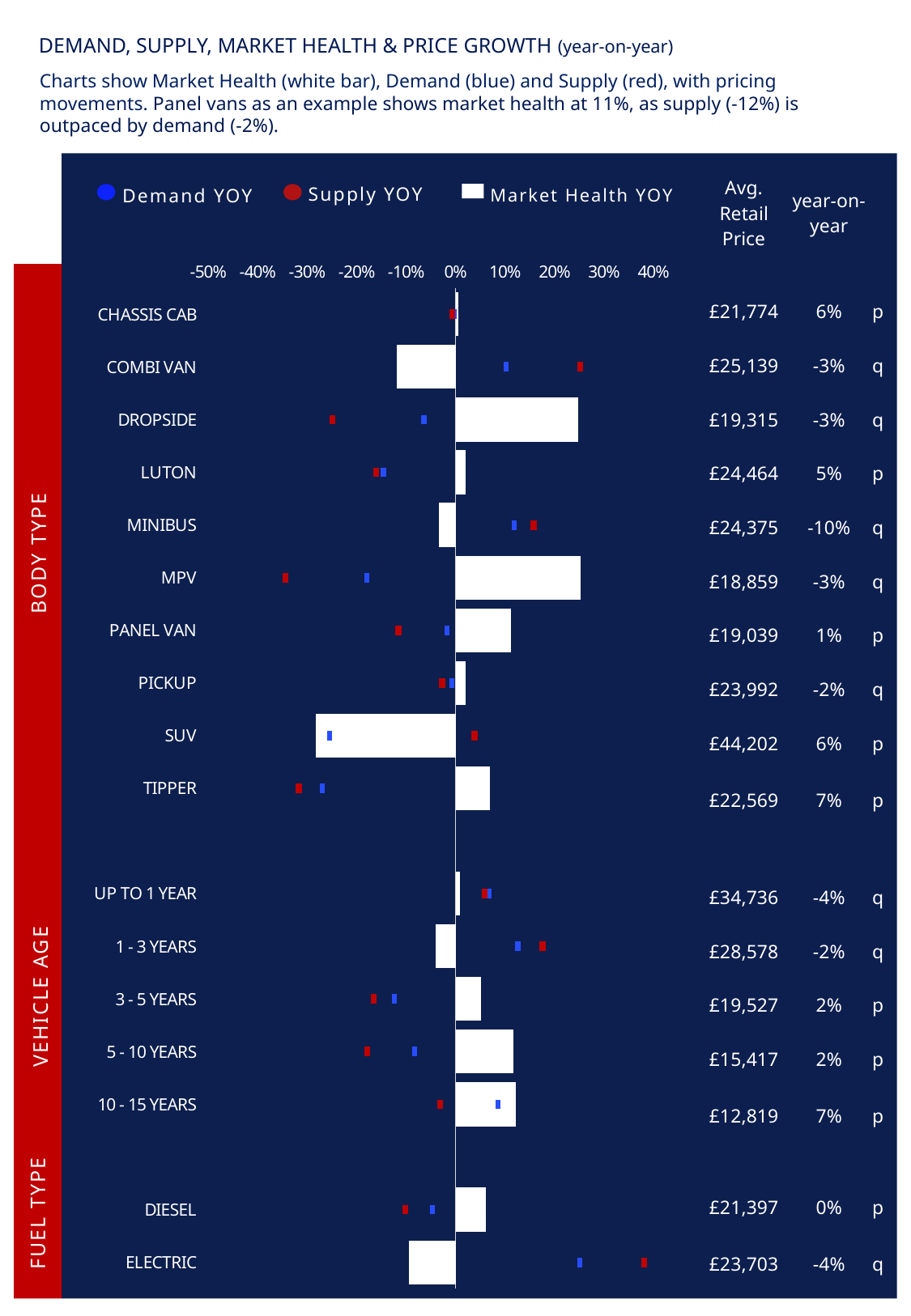
How many series does the chart legend list? 3 What is the Avg. Retail Price shown for SUV? £44,202 For DROPSIDE, which is larger: Demand YOY or Supply YOY? Demand YOY For ELECTRIC, which is larger: Demand YOY or Supply YOY? Supply YOY Which category has the lowest Market Health YOY (the longest white bar to the left of 0%)? SUV Is the Market Health YOY value for SUV greater or less than -20%? less What is the year-on-year price change shown for MINIBUS? -10% Which colour represents Supply YOY in the chart legend? red How many categories are plotted in the chart across all three groups (body type, vehicle age and fuel type)? 17 Is the Market Health YOY value for MPV greater or less than 20%? greater What kind of chart is shown on the slide? bar chart Is the Supply YOY value for ELECTRIC greater or less than 30%? greater